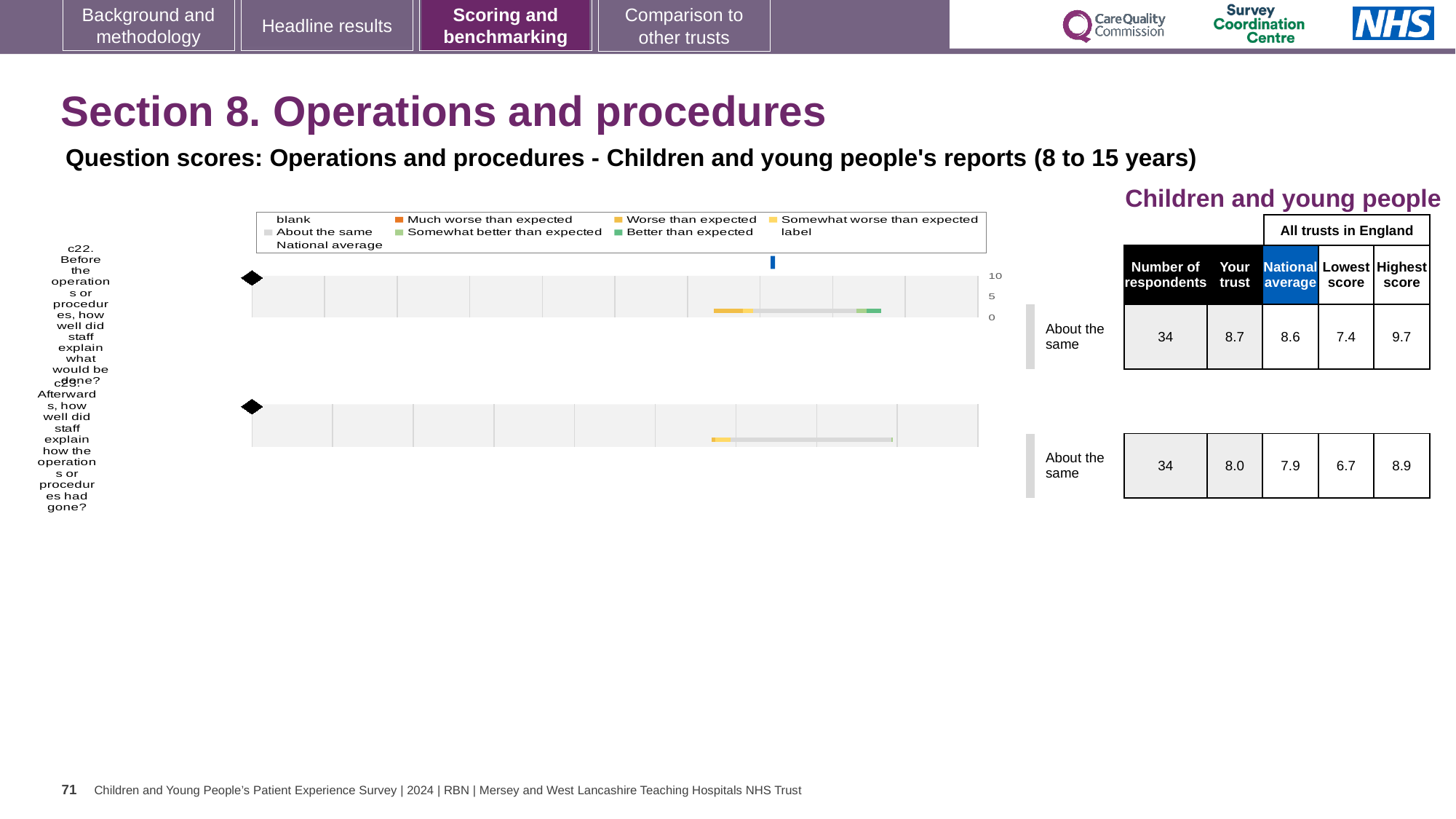
In the table beside the c23 chart, what is the 'Your trust' score? 8.0 In the table beside the c23 chart, what is the highest score among all trusts in England? 8.9 In the table beside the c22 chart, what is the national average score? 8.6 What kind of chart is used to show the question scores for c22 and c23? bar chart What is the highest tick value shown on the axis of the c22 chart? 10 How many questions (rows) are plotted in the benchmark charts on this slide? 2 What benchmark category is shown beside the c23 chart row? About the same In the table beside the c22 chart, what is the 'Your trust' score? 8.7 What benchmark category is shown beside the c22 chart row? About the same Which has the higher 'Your trust' score in the tables, c22 or c23? c22 Which legend entry is shown in orange? Much worse than expected What is the difference between the highest score and the lowest score for c22 in the table? 2.3